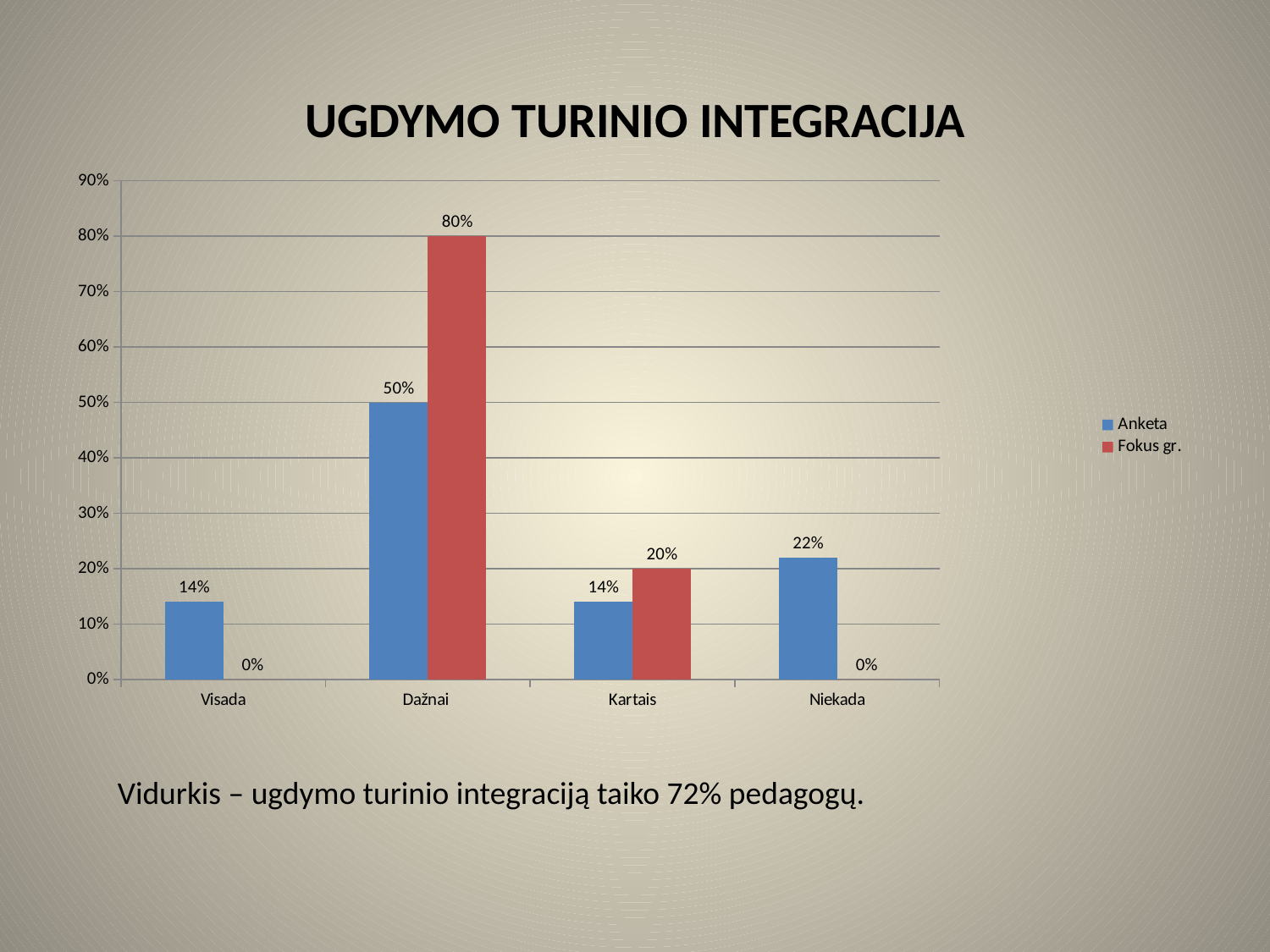
Which category has the highest Fokus gr. value? Dažnai What is the title of the chart? UGDYMO TURINIO INTEGRACIJA What is the Fokus gr. value for Visada? 0% What is the Fokus gr. value for Dažnai? 80% What is the Anketa value for Dažnai? 50% How many categories are shown on the x axis? 4 Which category has the highest Anketa value? Dažnai What kind of chart is shown on the slide? Bar chart How many series does the legend list? 2 What is the Anketa value for Niekada? 22% For Kartais, which series has the larger value, Anketa or Fokus gr.? Fokus gr. What is the difference between the Fokus gr. and Anketa values for Dažnai? 30%